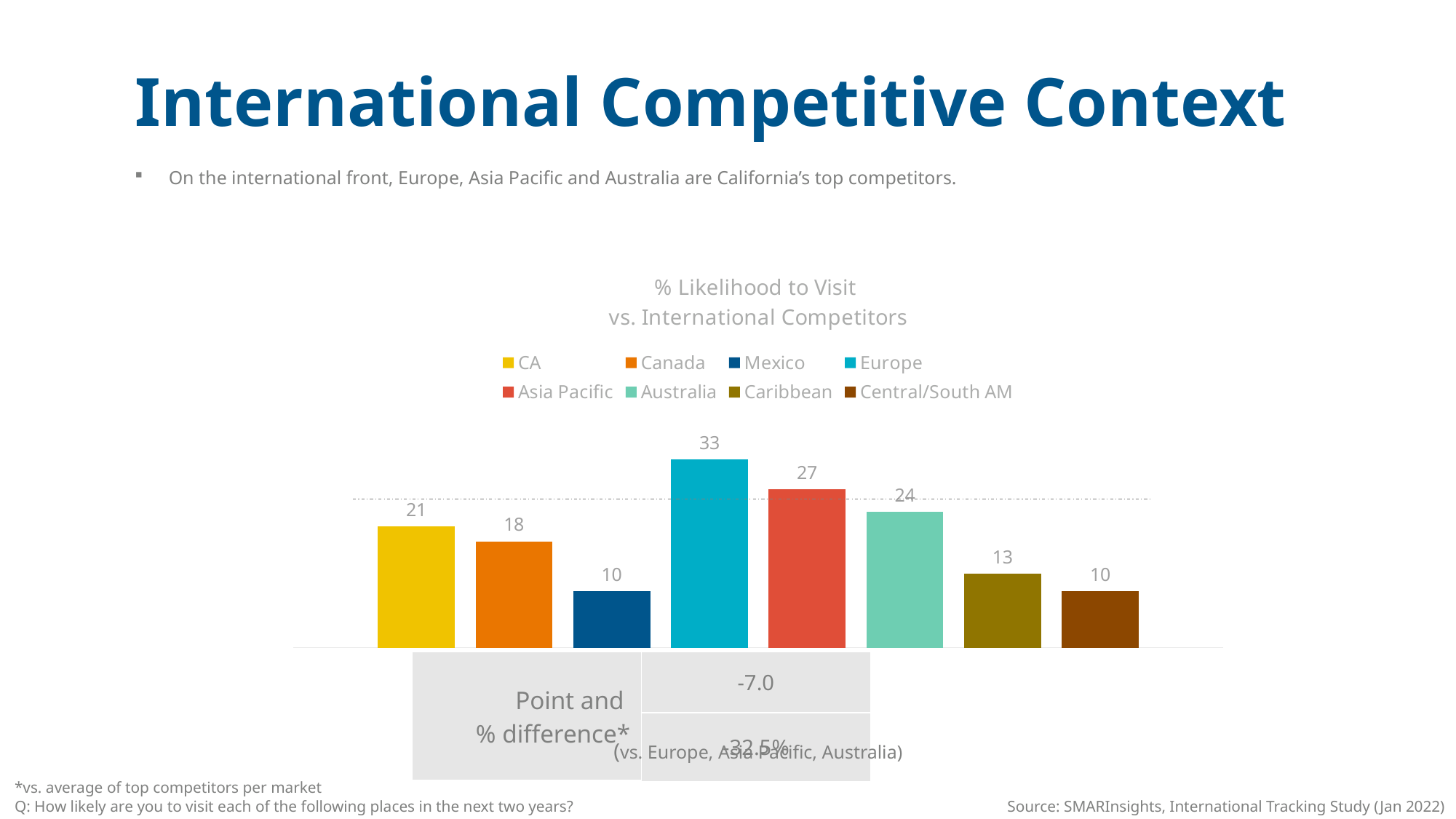
What is the difference between the values for Australia and Canada? 6 What is the value shown for Caribbean? 13 What is the % likelihood to visit value for Europe? 33 What is the difference between the values for Europe and CA? 12 How many bars are plotted in the chart? 8 Which has a larger value, Asia Pacific or Australia? Asia Pacific What type of chart is shown on the slide? Bar chart What is the value shown for Asia Pacific? 27 What is the value shown for CA? 21 Which has a larger value, Canada or Caribbean? Canada Which destination has the highest % likelihood to visit? Europe How many entries does the legend list? 8